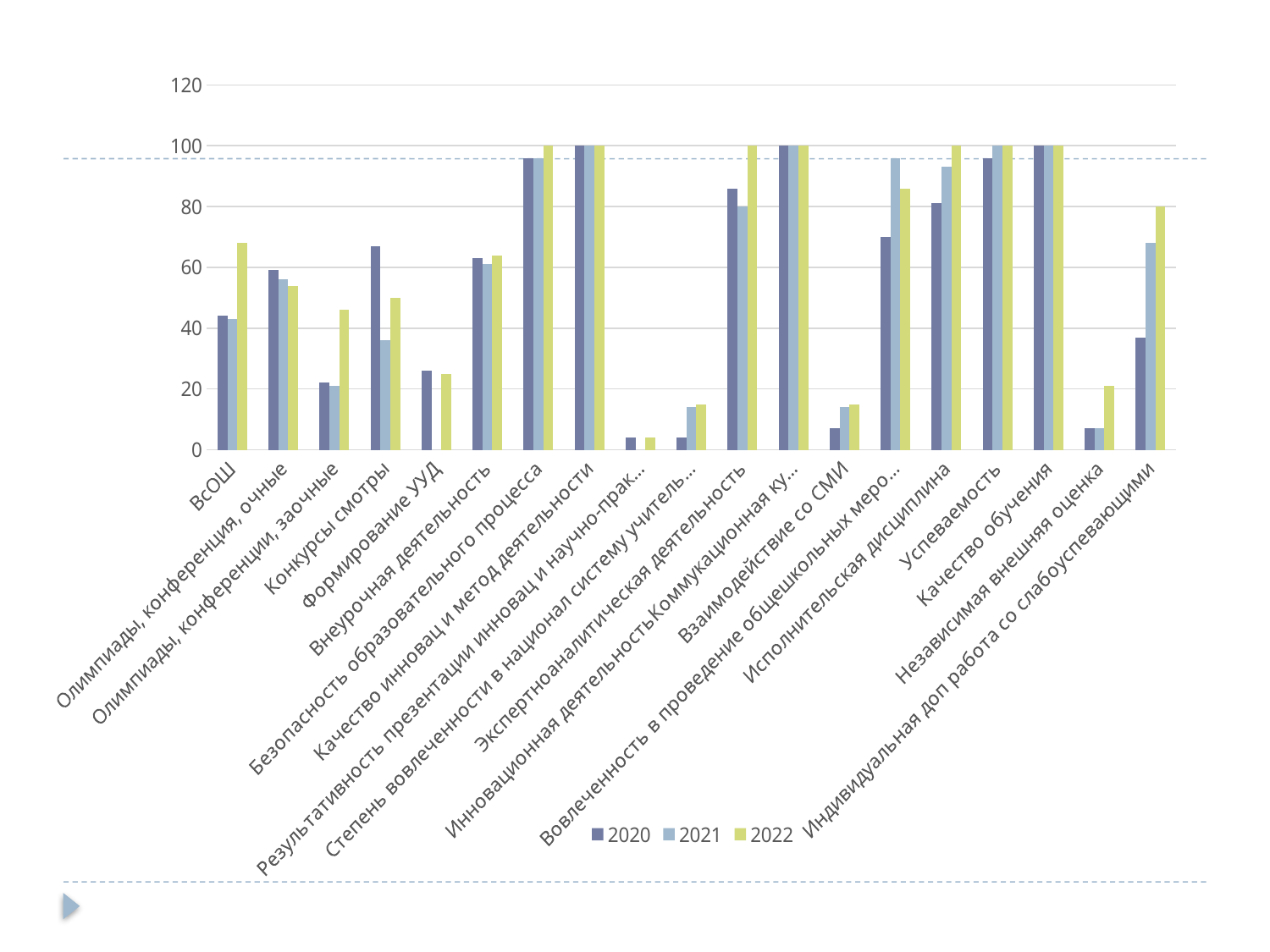
What is the value for 2020 in the category 'Качество инновац и метод деятельности'? 100 How many series does the legend list? 3 Is the value for 2020 in 'Взаимодействие со СМИ' greater or less than 20? less In the category 'ВсОШ', which is larger: the value for 2020 or the value for 2022? 2022 How many categories are shown along the x axis? 19 What is the value for 2022 in the category 'Индивидуальная доп работа со слабоуспевающими'? 80 What is the value for 2022 in the category 'Качество обучения'? 100 Is the value for 2022 in 'ВсОШ' greater or less than 60? greater What kind of chart is shown on the slide? bar chart Which series is shown in yellow-green in the legend? 2022 Is the value for 2020 in 'Конкурсы смотры' greater or less than 60? greater Which category has the lowest value for 2022? Результативность презентации инновац и научно-прак...